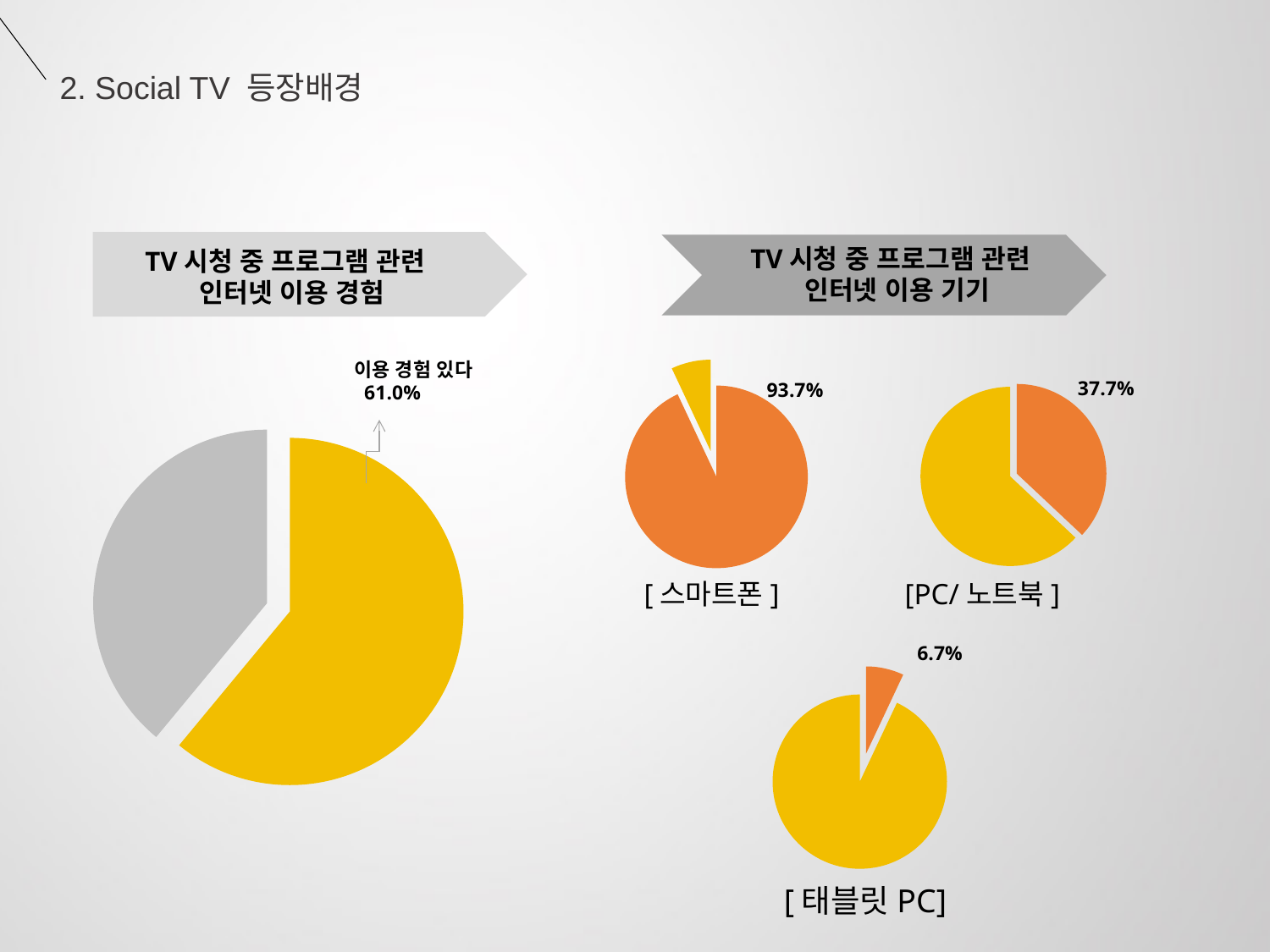
Among the three device pie charts on the right (스마트폰, PC/ 노트북, 태블릿 PC), which device has the highest labelled percentage? 스마트폰 How many pie charts are shown under the heading TV 시청 중 프로그램 관련 인터넷 이용 기기 on the right side of the slide? 3 Which is larger: the labelled percentage on the PC/ 노트북 pie chart or the labelled percentage on the 태블릿 PC pie chart? PC/ 노트북 On the left pie chart (TV 시청 중 프로그램 관련 인터넷 이용 경험), what percentage is labelled for 이용 경험 있다? 61.0% What is the difference between the labelled percentage on the 스마트폰 pie chart and the labelled percentage on the PC/ 노트북 pie chart? 56.0% On the PC/ 노트북 pie chart, what percentage is printed for the orange slice? 37.7% What kind of chart is used for the 스마트폰 data on the right side of the slide? pie chart On the left pie chart (TV 시청 중 프로그램 관련 인터넷 이용 경험), how many slices does the pie have? 2 On the 스마트폰 pie chart, what percentage is printed for the orange slice? 93.7% Among the three device pie charts on the right (스마트폰, PC/ 노트북, 태블릿 PC), which device has the lowest labelled percentage? 태블릿 PC On the 태블릿 PC pie chart, what percentage is printed for the orange slice? 6.7% On the left pie chart (TV 시청 중 프로그램 관련 인터넷 이용 경험), what colour is the slice labelled 이용 경험 있다? yellow